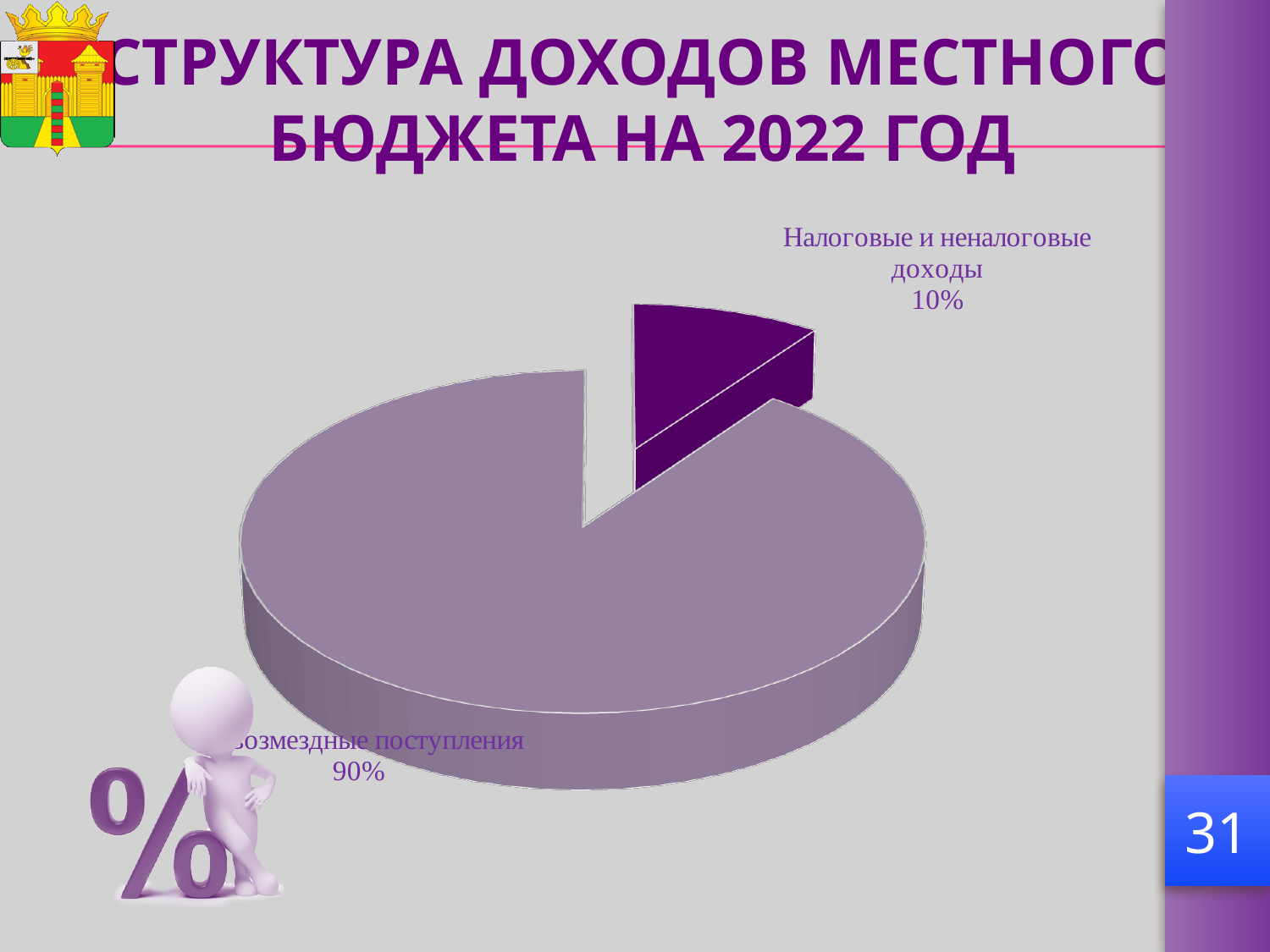
What share of the pie is labelled "Безвозмездные поступления"? 90% What is the total of the two percentages shown on the pie chart? 100% What kind of chart is shown on the slide? Pie chart What is the difference in percentage points between the "Безвозмездные поступления" slice and the "Налоговые и неналоговые доходы" slice? 80 percentage points Which is larger: the share for "Налоговые и неналоговые доходы" or the share for "Безвозмездные поступления"? Безвозмездные поступления Which slice of the pie is the smallest? Налоговые и неналоговые доходы How many slices does the pie chart have? 2 Which slice of the pie is drawn in dark purple and pulled out from the rest of the pie? Налоговые и неналоговые доходы What share of the pie is labelled "Налоговые и неналоговые доходы"? 10% What is the title of the slide containing the pie chart? СТРУКТУРА ДОХОДОВ МЕСТНОГО БЮДЖЕТА НА 2022 ГОД Which slice of the pie is the largest? Безвозмездные поступления